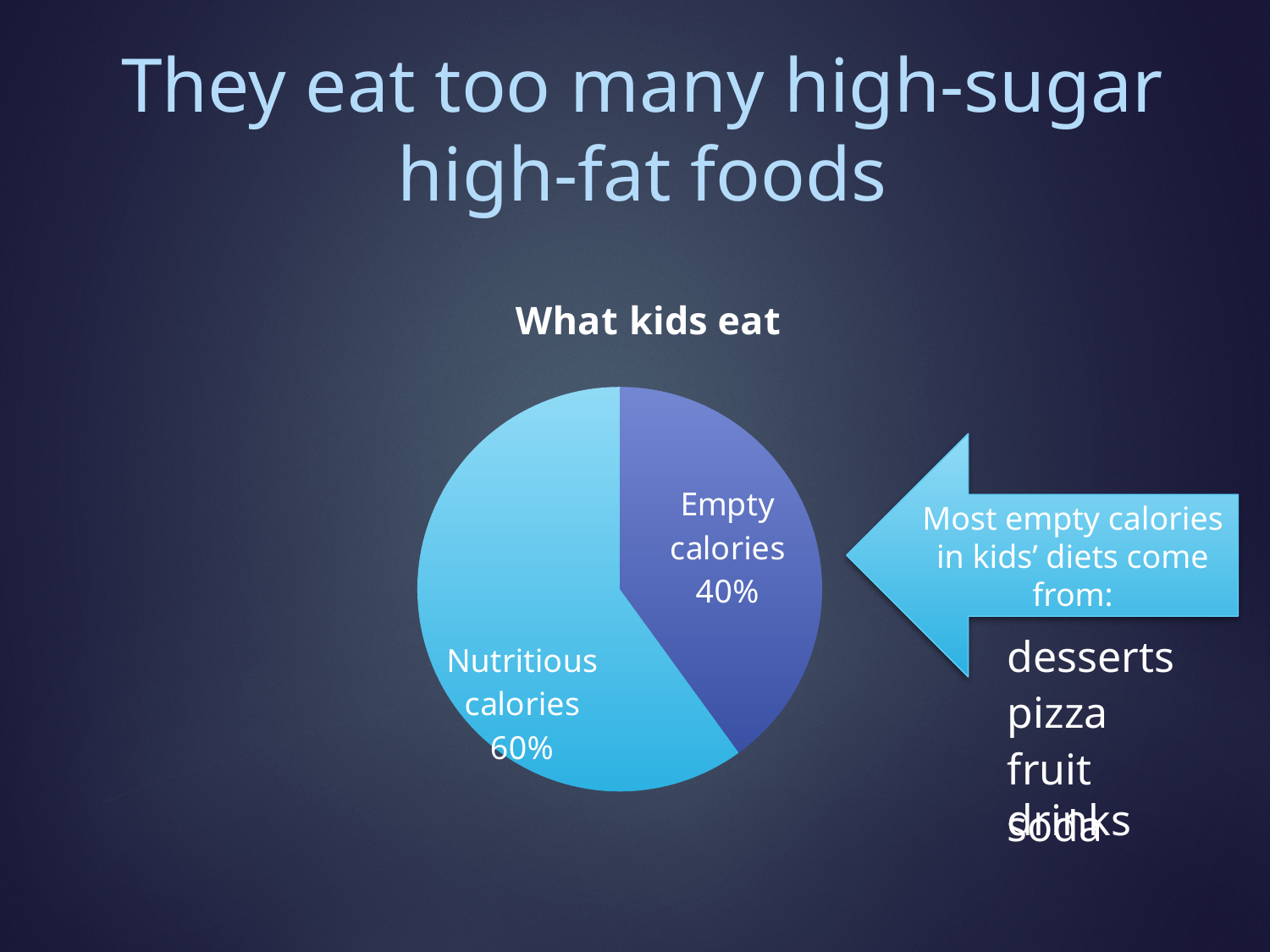
What is the difference in percentage points between Nutritious calories and Empty calories? 20% What share of the pie is Empty calories? 40% What is the title of the chart? What kids eat Which is larger, the Empty calories slice or the Nutritious calories slice? Nutritious calories Which slice of the pie is the smallest? Empty calories Is the share for Nutritious calories greater or less than 50%? greater How many slices does the pie chart have? 2 Which slice of the pie is the largest? Nutritious calories What kind of chart is shown on the slide? pie chart What share of the pie is Nutritious calories? 60% Is the share for Empty calories greater or less than 50%? less